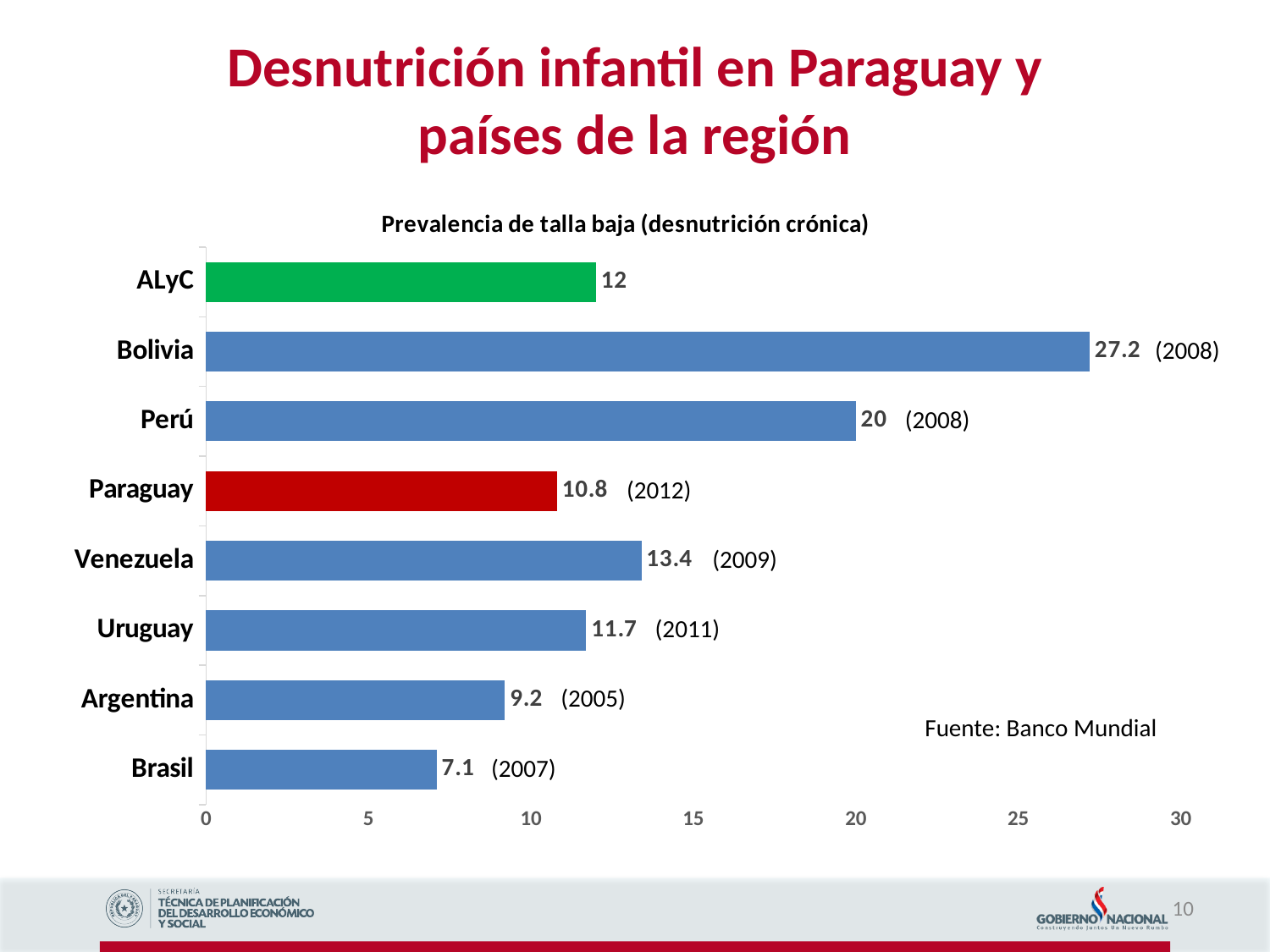
How many categories are shown in the chart? 8 What is the difference between the values for Bolivia and Perú? 7.2 What is the title of the chart? Prevalencia de talla baja (desnutrición crónica) What is the value for Bolivia in the chart? 27.2 What is the difference between the values for Venezuela and Paraguay? 2.6 What is the value for ALyC in the chart? 12 Which category has the highest value in the chart? Bolivia Is the value for Perú greater or less than 15? greater Which category has the lowest value in the chart? Brasil Which has a larger value, Uruguay or Argentina? Uruguay What kind of chart is shown on the slide? bar chart What is the value for Paraguay in the chart? 10.8